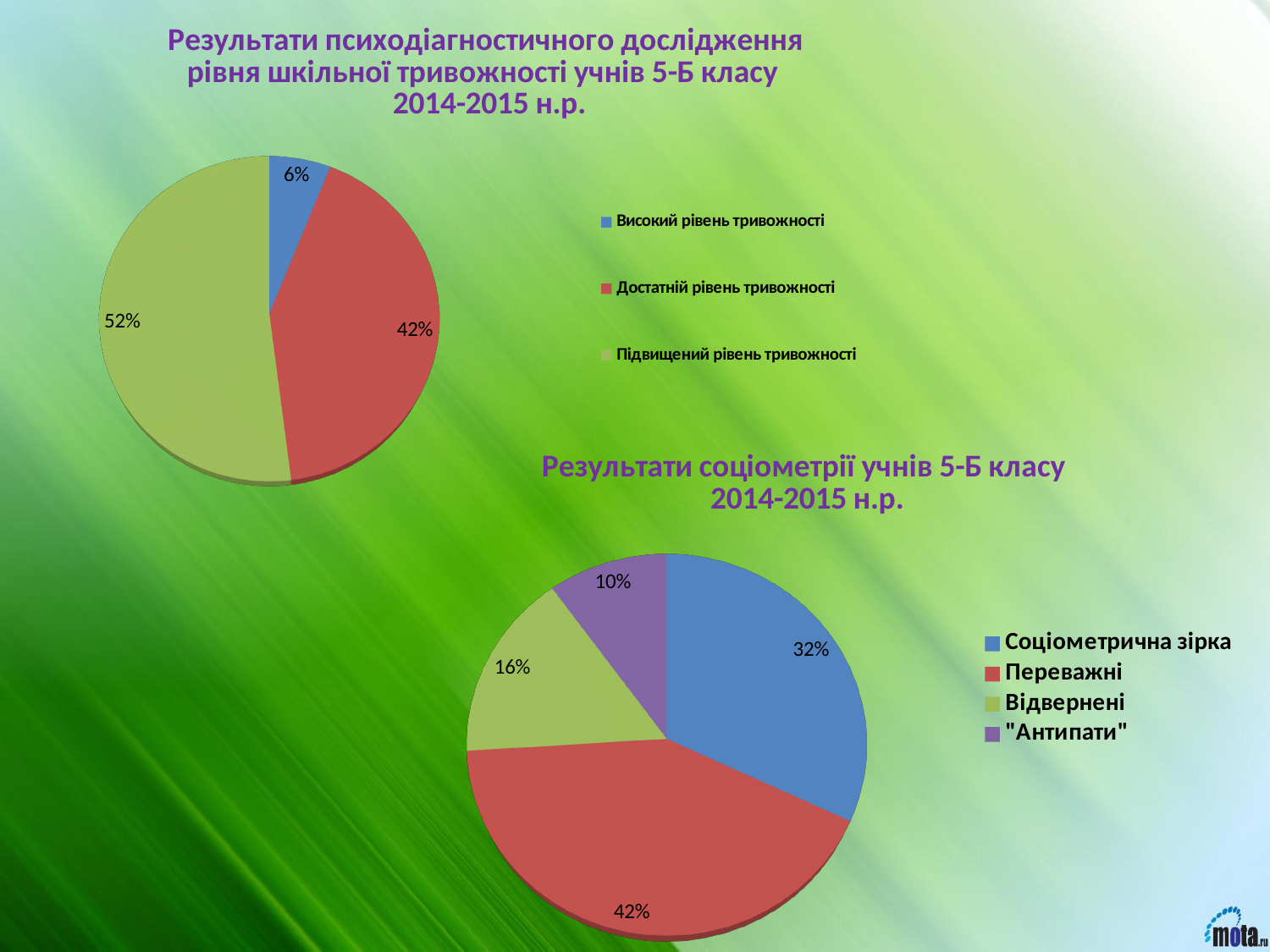
In the top-left pie chart (school anxiety levels), which category has the smallest slice? Високий рівень тривожності In the bottom-right pie chart (sociometry results), what share is labelled for "Соціометрична зірка"? 32% In the bottom-right pie chart (sociometry results), which category has the largest slice? Переважні In the bottom-right pie chart (sociometry results), what share is labelled for "Відвернені"? 16% In the top-left pie chart (school anxiety levels), which category has the largest slice? Підвищений рівень тривожності In the top-left pie chart (school anxiety levels), what is the difference between the shares for "Підвищений рівень тривожності" and "Достатній рівень тривожності"? 10% In the top-left pie chart (school anxiety levels), what share is labelled for "Високий рівень тривожності"? 6% In the bottom-right pie chart (sociometry results), which is larger: the share for "Соціометрична зірка" or the share for "Відвернені"? Соціометрична зірка How many slices does the top-left pie chart (school anxiety levels) have? 3 How many entries does the legend of the bottom-right pie chart (sociometry results) list? 4 In the top-left pie chart (school anxiety levels), what share is labelled for "Підвищений рівень тривожності"? 52% In the bottom-right pie chart (sociometry results), which category has the smallest slice? "Антипати"